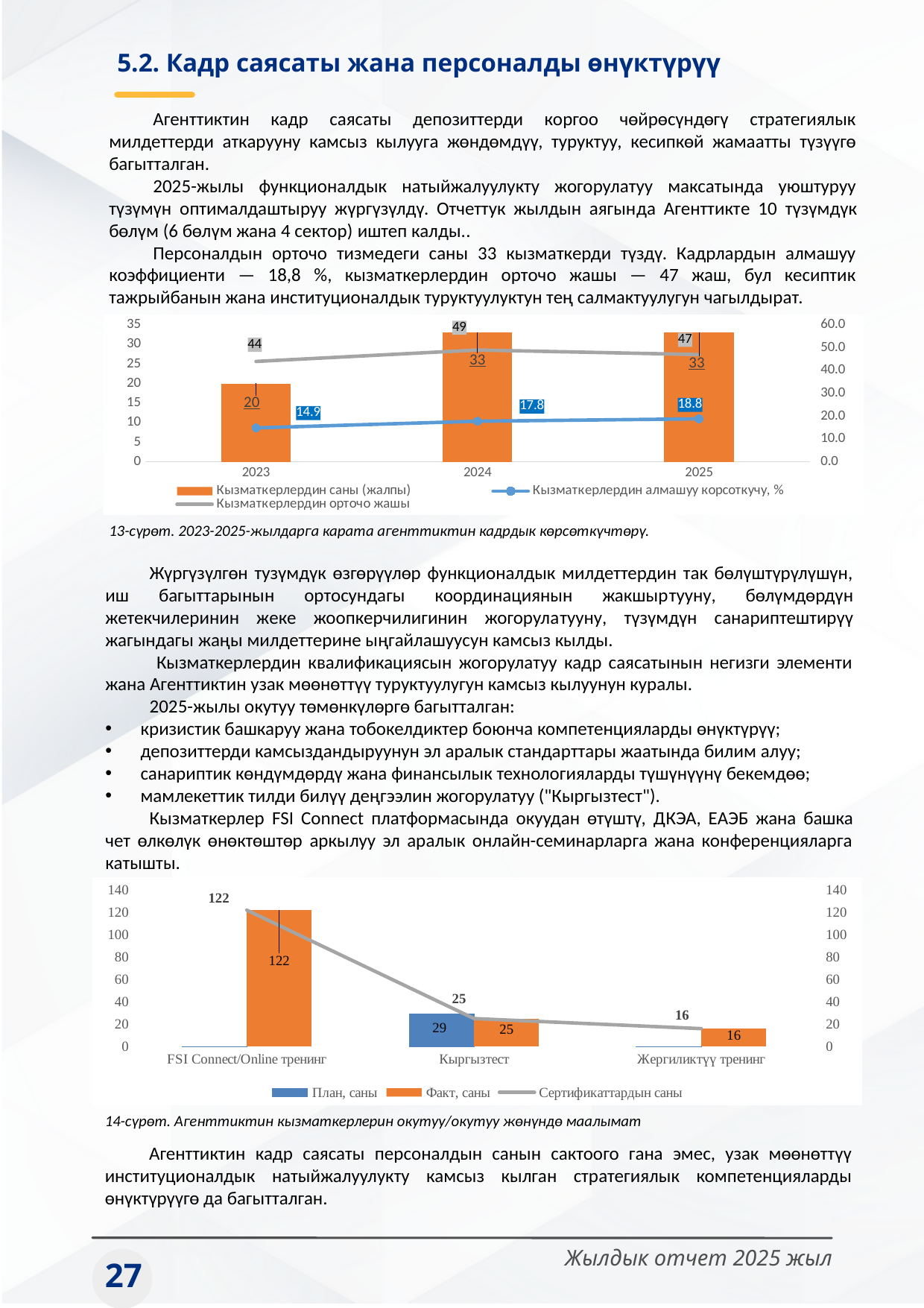
In the top chart, what is the average age of employees (Кызматкерлердин орточо жашы) in 2023? 44 In the top chart, which year has the highest average age of employees? 2024 In the top chart, by how much did the number of employees increase from 2023 to 2024? 13 In the bottom chart, what is the difference between the planned and actual numbers for Кыргызтест? 4 How many series does the legend of the top chart list? 3 In the bottom chart, what is the planned number (План, саны) for Кыргызтест? 29 In the top chart, which year has the lowest number of employees? 2023 In the top chart, does the turnover rate rise or fall from 2023 to 2025? rise In the top chart, what is the turnover rate (Кызматкерлердин алмашуу корсоткучу, %) for 2025? 18.8 In the bottom chart, which category has the lowest number of certificates (Сертификаттардын саны)? Жергиликтүү тренинг In the bottom chart, what is the actual number (Факт, саны) for FSI Connect/Online тренинг? 122 In the top chart, what is the number of employees (Кызматкерлердин саны) for 2024? 33